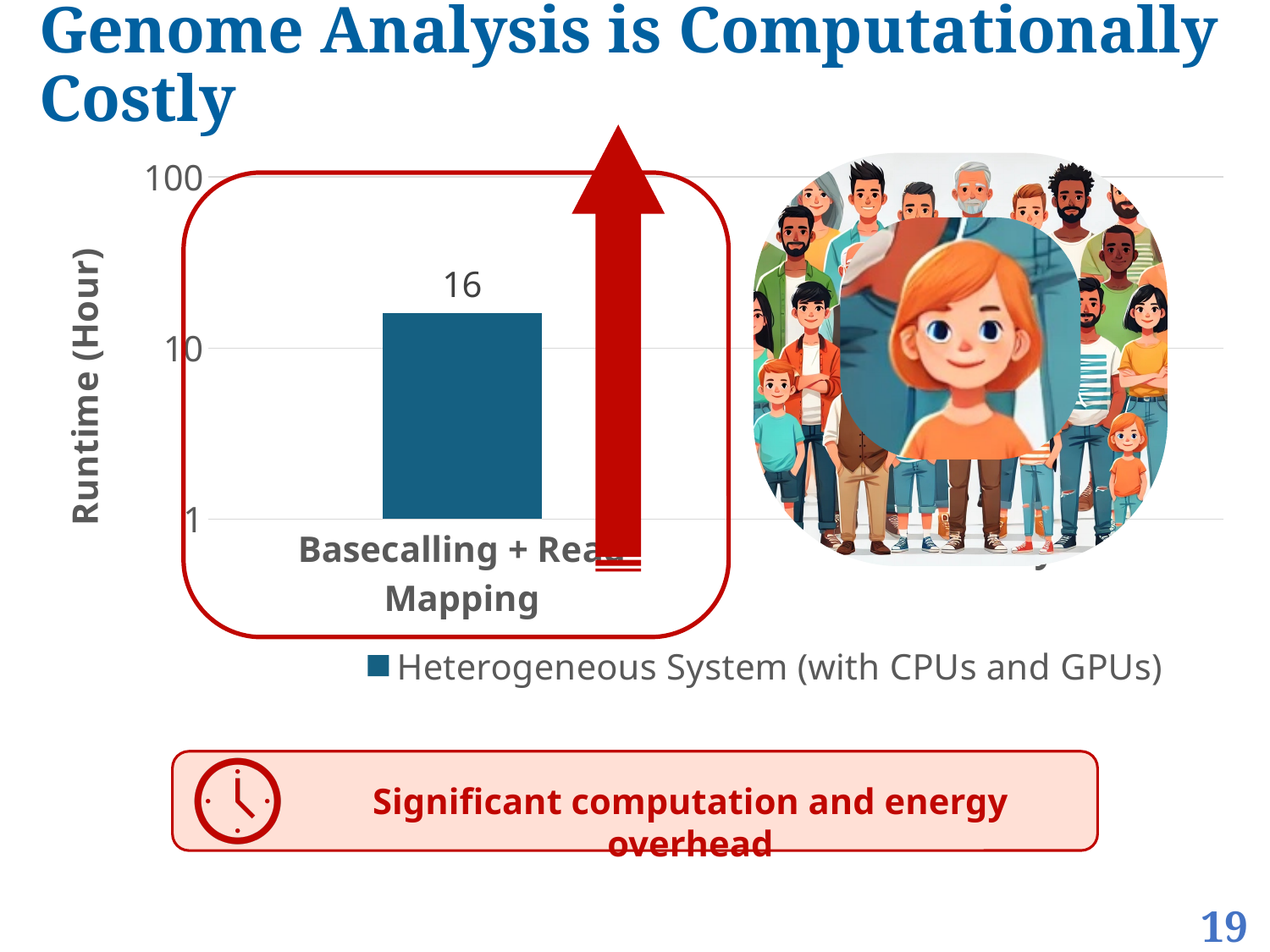
Is the value for Basecalling + Read Mapping greater or less than 100? less What kind of chart is shown on the slide? bar chart How many series does the chart legend list? 1 What is the label of the y-axis? Runtime (Hour) What series name is shown in the chart legend? Heterogeneous System (with CPUs and GPUs) Is the value for Basecalling + Read Mapping greater or less than 10? greater What is the runtime value shown for Basecalling + Read Mapping? 16